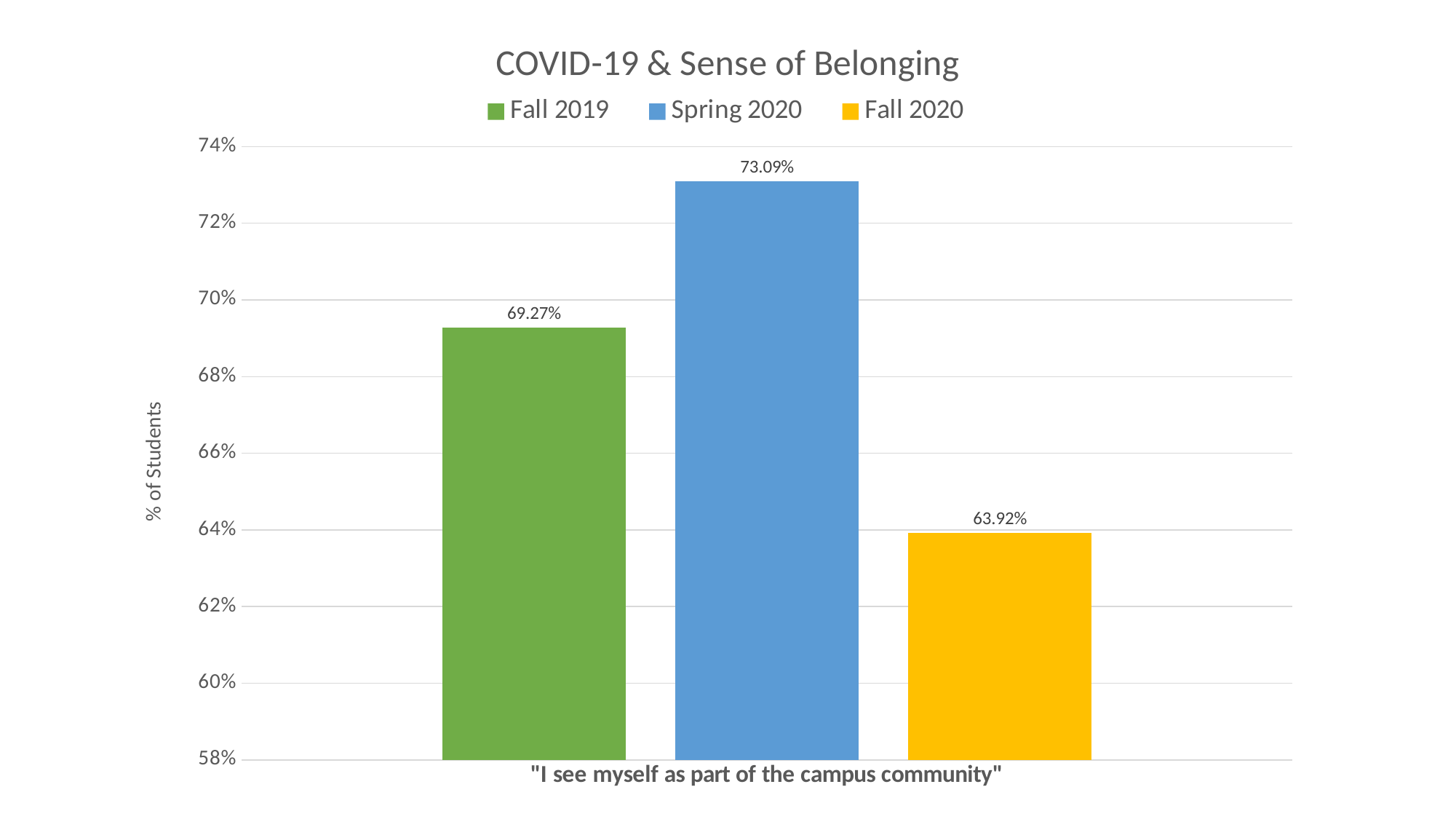
What is the value for Fall 2020? 63.92% How many series does the legend list? 3 What is the value for Fall 2019? 69.27% Which is larger, the value for Fall 2019 or the value for Fall 2020? Fall 2019 Is the value for Fall 2020 greater or less than 66%? less What is the difference between the Spring 2020 and Fall 2019 values? 3.82% What is the title of the chart? COVID-19 & Sense of Belonging Which series has the lowest value? Fall 2020 What is the value for Spring 2020? 73.09% Which series has the highest value? Spring 2020 What kind of chart is shown on the slide? bar chart What is the difference between the Spring 2020 and Fall 2020 values? 9.17%